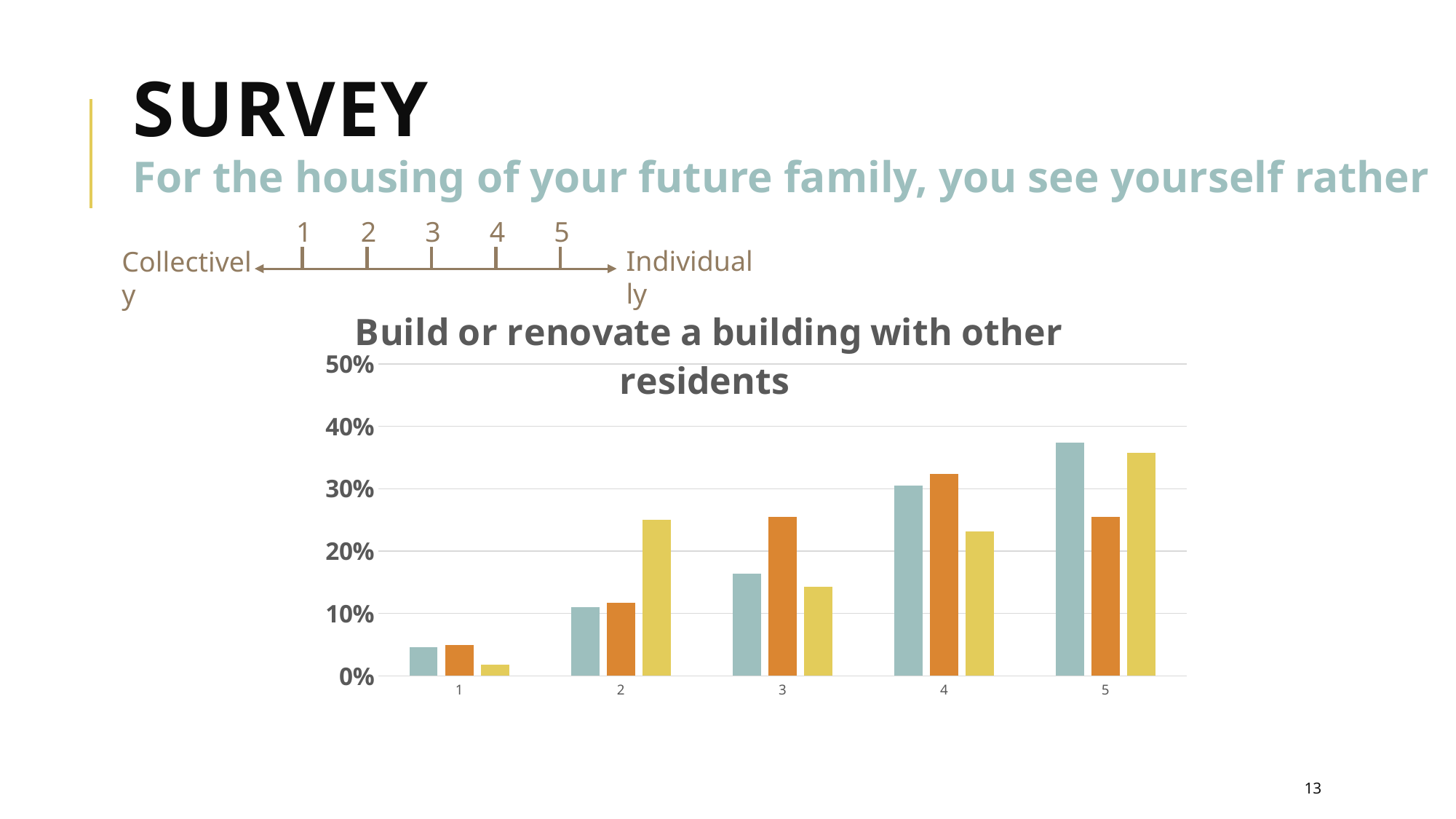
What kind of chart is shown on the slide? bar chart Is the value of the teal bar for category 5 greater or less than 30%? greater Is the value of the orange bar for category 5 greater or less than 30%? less For which category is the teal bar the tallest? 5 For which category is the orange bar the tallest? 4 How many categories are shown on the x axis of the chart? 5 What is the title of the chart? Build or renovate a building with other residents In category 3, which bar is taller, the orange one or the yellow one? orange How many bars are plotted for each category on the x axis? 3 Do the teal bars rise or fall from category 1 to category 5? rise Is the value of the yellow bar for category 2 greater or less than 20%? greater